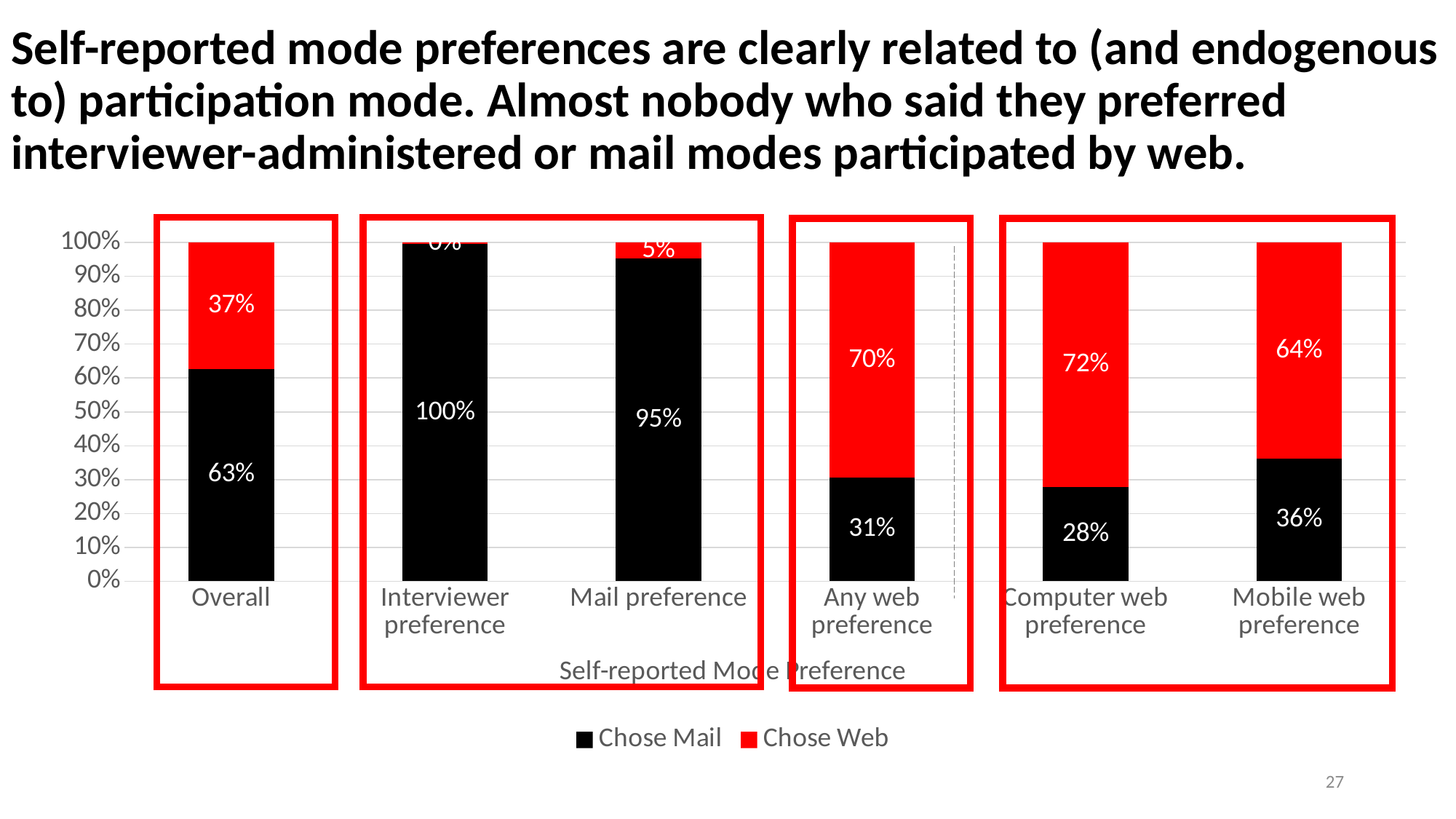
What percentage of respondents with a Computer web preference chose web? 72% How many series does the legend list? 2 What is the difference between the Chose Web share for Computer web preference and for Mobile web preference? 8% What kind of chart is shown on the slide? Stacked bar chart Which colour represents the Chose Web series? Red Which is larger: the Chose Mail share for Any web preference or for Mobile web preference? Mobile web preference Which category has the lowest share of respondents who chose mail? Computer web preference How many categories are shown on the x axis? 6 Which category has the highest share of respondents who chose mail? Interviewer preference What percentage of respondents with a Mobile web preference chose mail? 36% What percentage of the Overall group chose mail? 63% What percentage of respondents with a Mail preference chose web? 5%